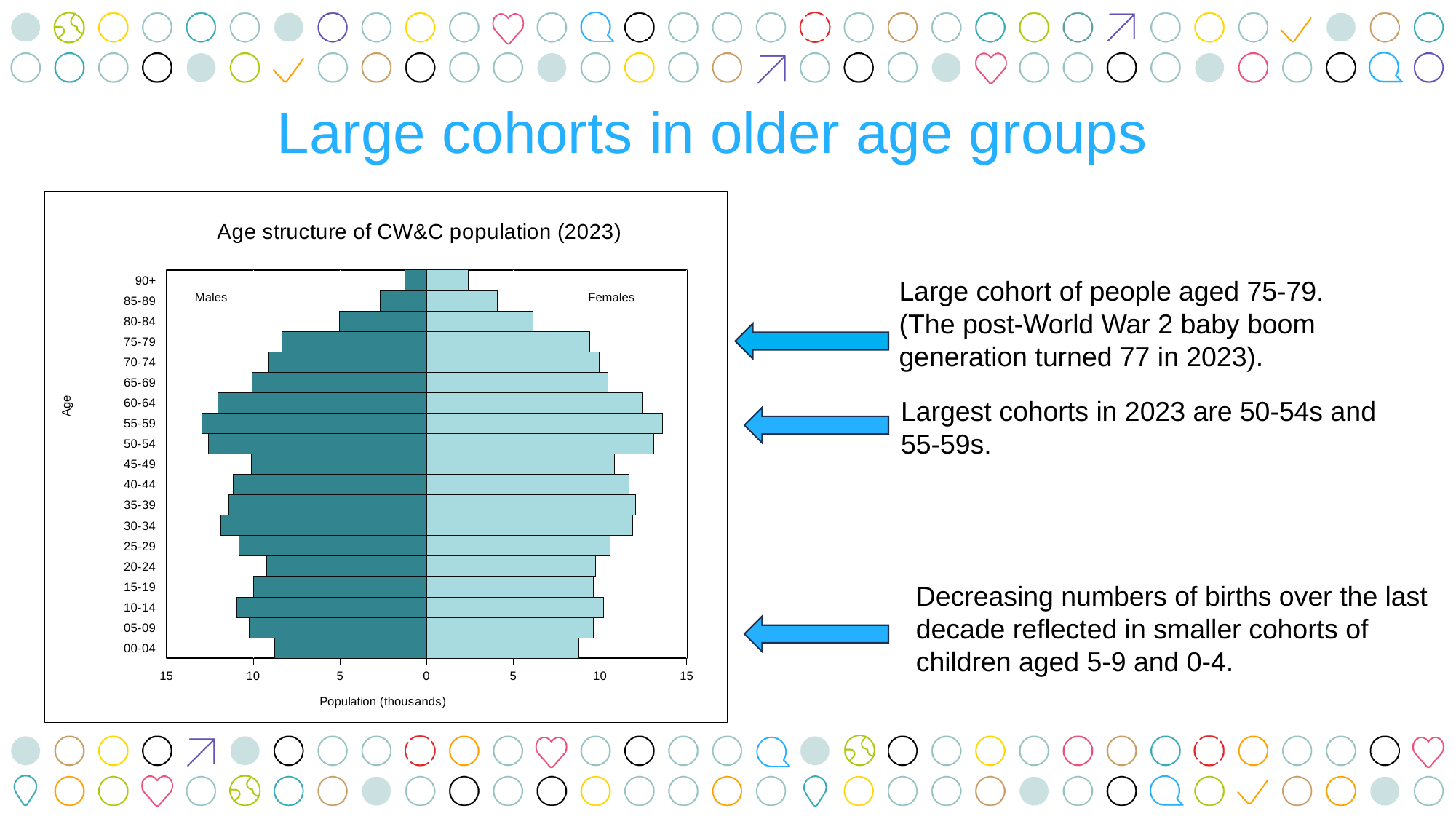
What is the title of the chart? Age structure of CW&C population (2023) Which age group has the smallest male population in the chart? 90+ What is the label on the horizontal axis of the chart? Population (thousands) Is the female population for the 90+ age group greater or less than 5 thousand? less What kind of chart is shown on the slide? bar chart How many age groups are shown on the vertical axis of the chart? 19 Is the male population for the 00-04 age group greater or less than 10 thousand? less Which age group has the largest male population in the chart? 55-59 In the 80-84 age group, is the male or the female population larger? Females Is the female population for the 50-54 age group greater or less than 10 thousand? greater Which age group has the smallest female population in the chart? 90+